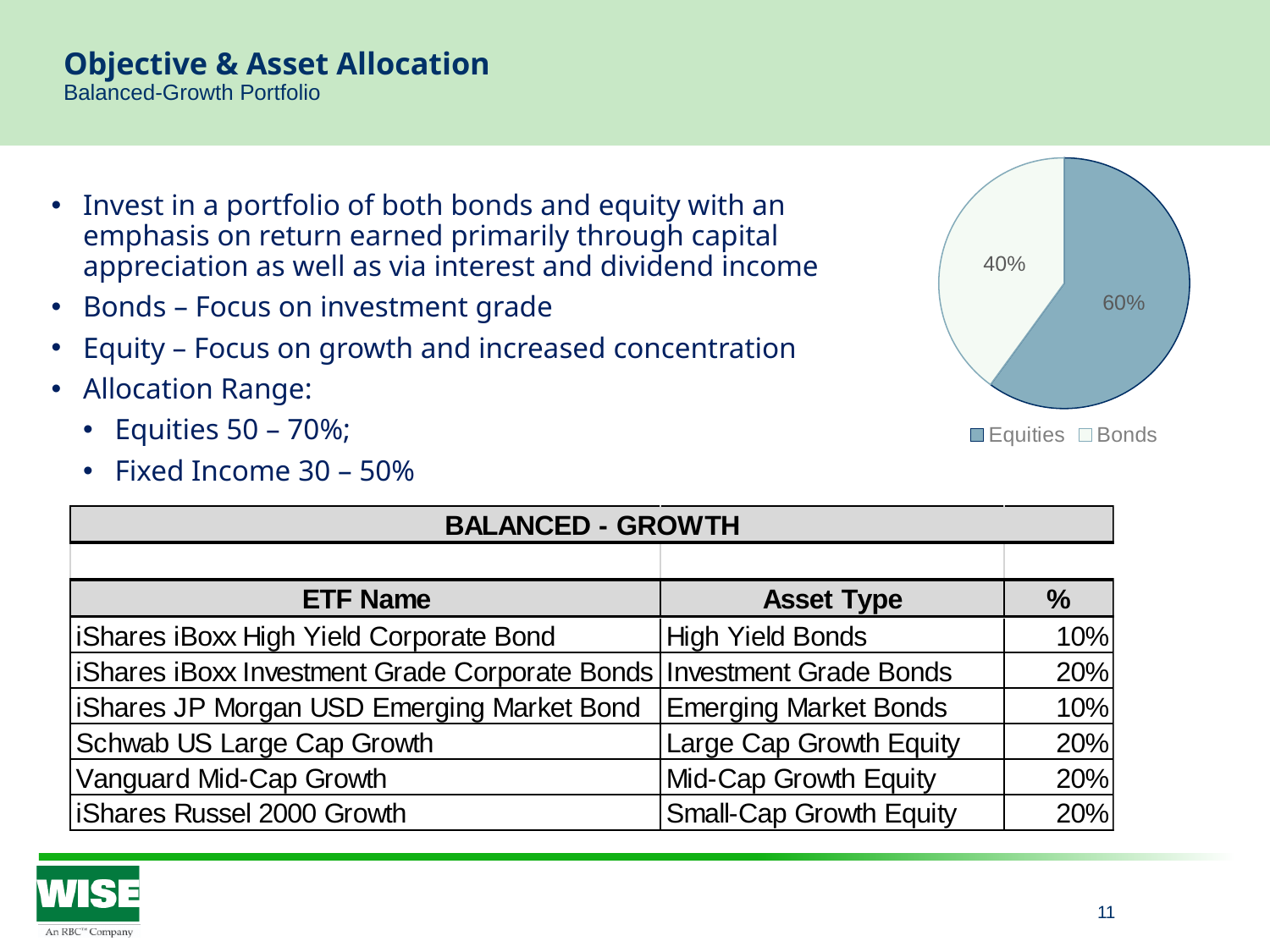
What kind of chart is shown on the slide? pie chart Which slice of the pie chart is the smallest? Bonds What are the two categories listed in the pie chart's legend? Equities and Bonds Which slice of the pie chart is shaded in the darker blue colour? Equities How many slices does the pie chart have? 2 Which is larger in the pie chart, Equities or Bonds? Equities How many entries does the pie chart's legend list? 2 What share of the pie chart is Equities? 60% What is the difference in percentage points between the Equities slice and the Bonds slice? 20% Which slice of the pie chart is the largest? Equities What share of the pie chart is Bonds? 40%